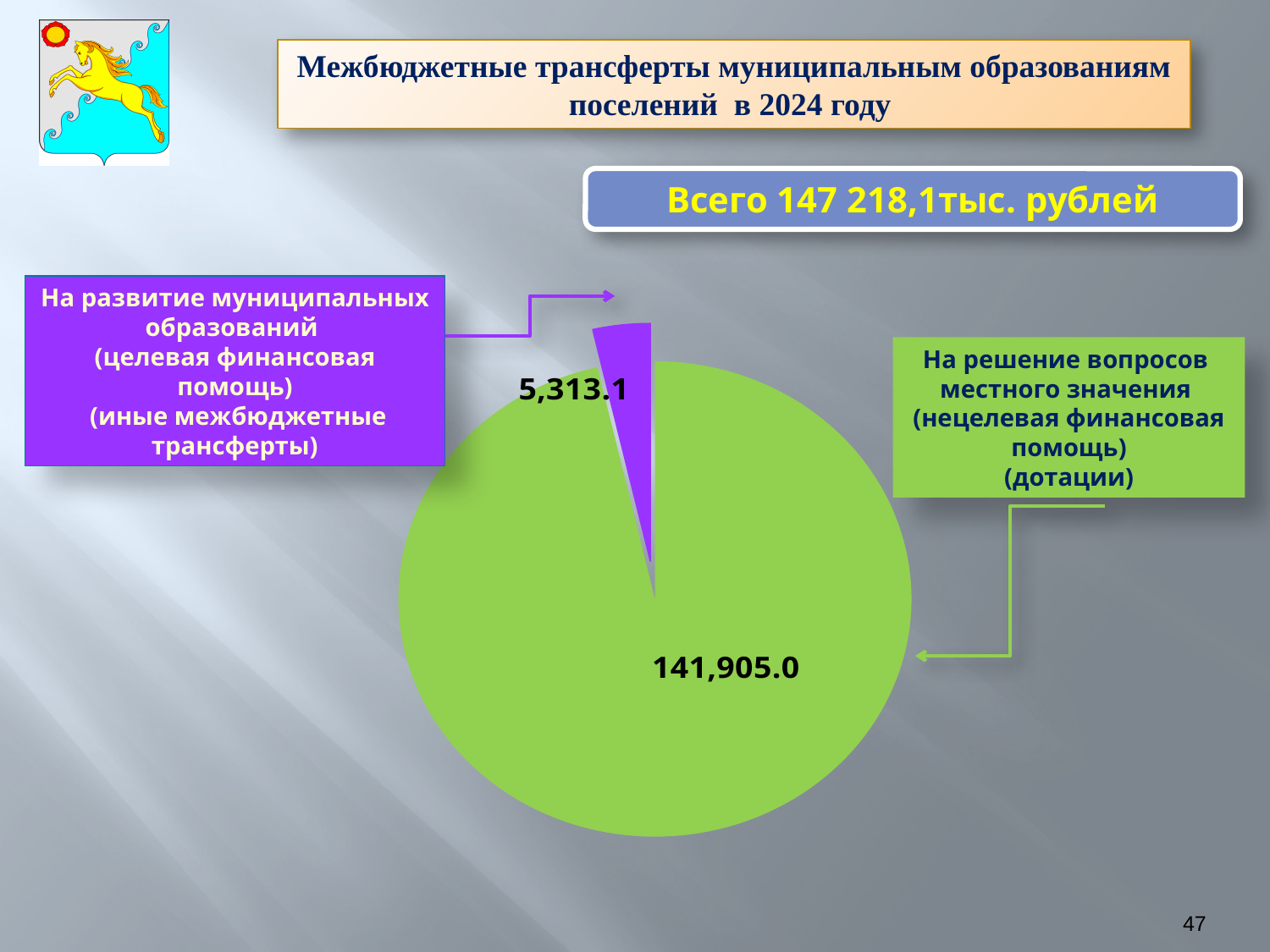
What is the value of the slice for 'На решение вопросов местного значения (нецелевая финансовая помощь) (дотации)'? 141,905.0 What is the value of the slice for 'На развитие муниципальных образований (целевая финансовая помощь) (иные межбюджетные трансферты)'? 5,313.1 What is the difference between the value for дотации (141,905.0) and the value for иные межбюджетные трансферты (5,313.1)? 136,591.9 How many slices does the pie chart have? 2 What type of chart is shown on the slide? pie chart Approximately what share of the pie does the slice for иные межбюджетные трансферты (5,313.1 of 147,218.1) represent, rounded to one decimal place? 3.6% Which slice of the pie chart is the smallest? На развитие муниципальных образований (целевая финансовая помощь) (иные межбюджетные трансферты) Which slice of the pie chart is the largest? На решение вопросов местного значения (нецелевая финансовая помощь) (дотации) Which is larger: the slice for дотации or the slice for иные межбюджетные трансферты? дотации What total amount is stated in the blue box on the slide? 147 218,1 тыс. рублей What colour is the slice for 'На решение вопросов местного значения (дотации)'? green What is the total of the two slices in the pie chart? 147,218.1